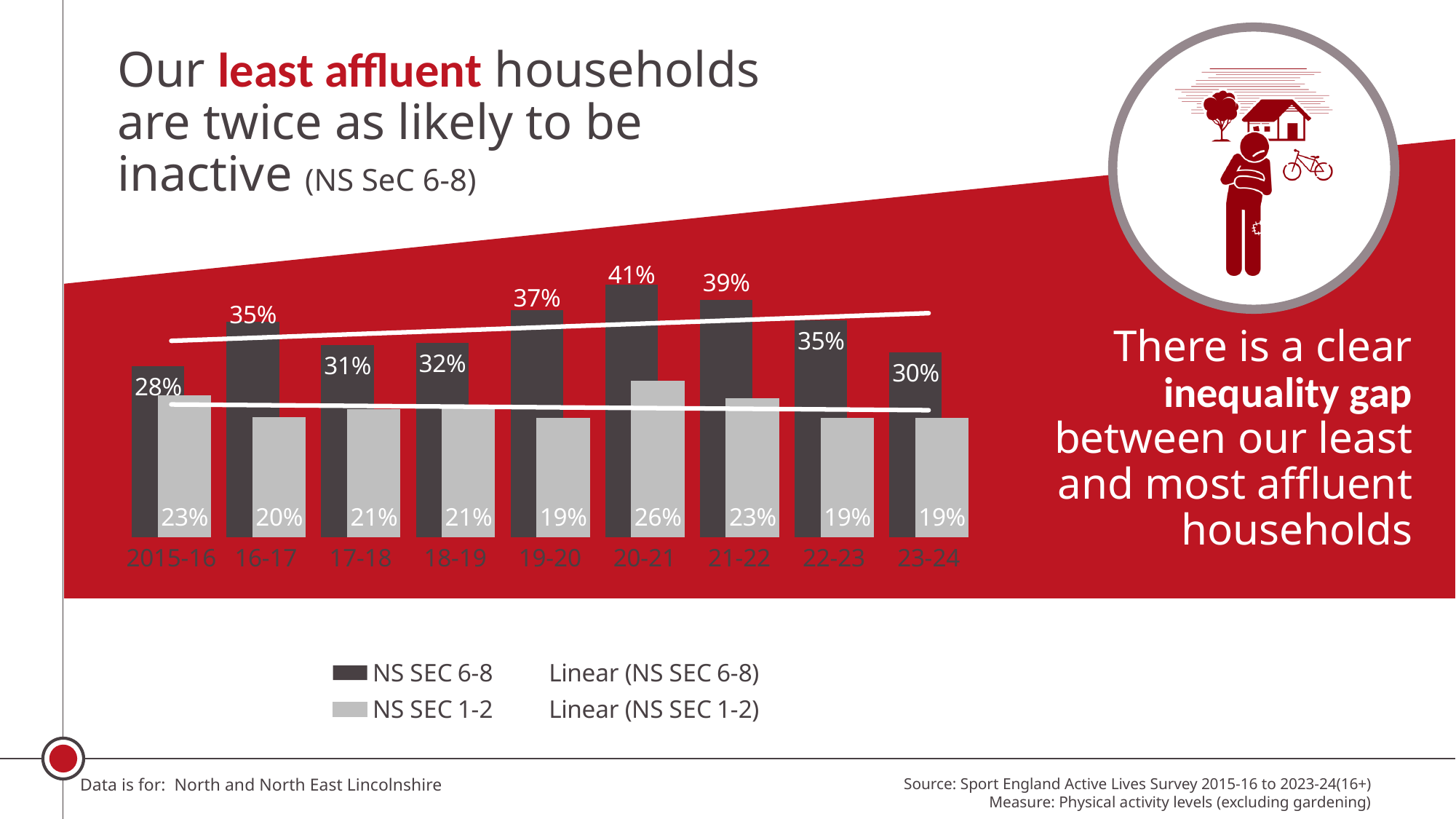
In which year is the NS SEC 6-8 value lowest? 2015-16 How many years are shown on the x axis? 9 Which is larger, the NS SEC 6-8 value in 19-20 or in 22-23? 19-20 In which year is the NS SEC 6-8 value highest? 20-21 What is the value for NS SEC 6-8 in 2015-16? 28% What is the difference between the NS SEC 6-8 and NS SEC 1-2 values in 2015-16? 5 percentage points What is the value for NS SEC 1-2 in 20-21? 26% What kind of chart is shown? Bar chart What is the difference between the NS SEC 6-8 and NS SEC 1-2 values in 20-21? 15 percentage points In which year is the NS SEC 1-2 value highest? 20-21 How many entries does the legend list? 4 What is the value for NS SEC 6-8 in 23-24? 30%